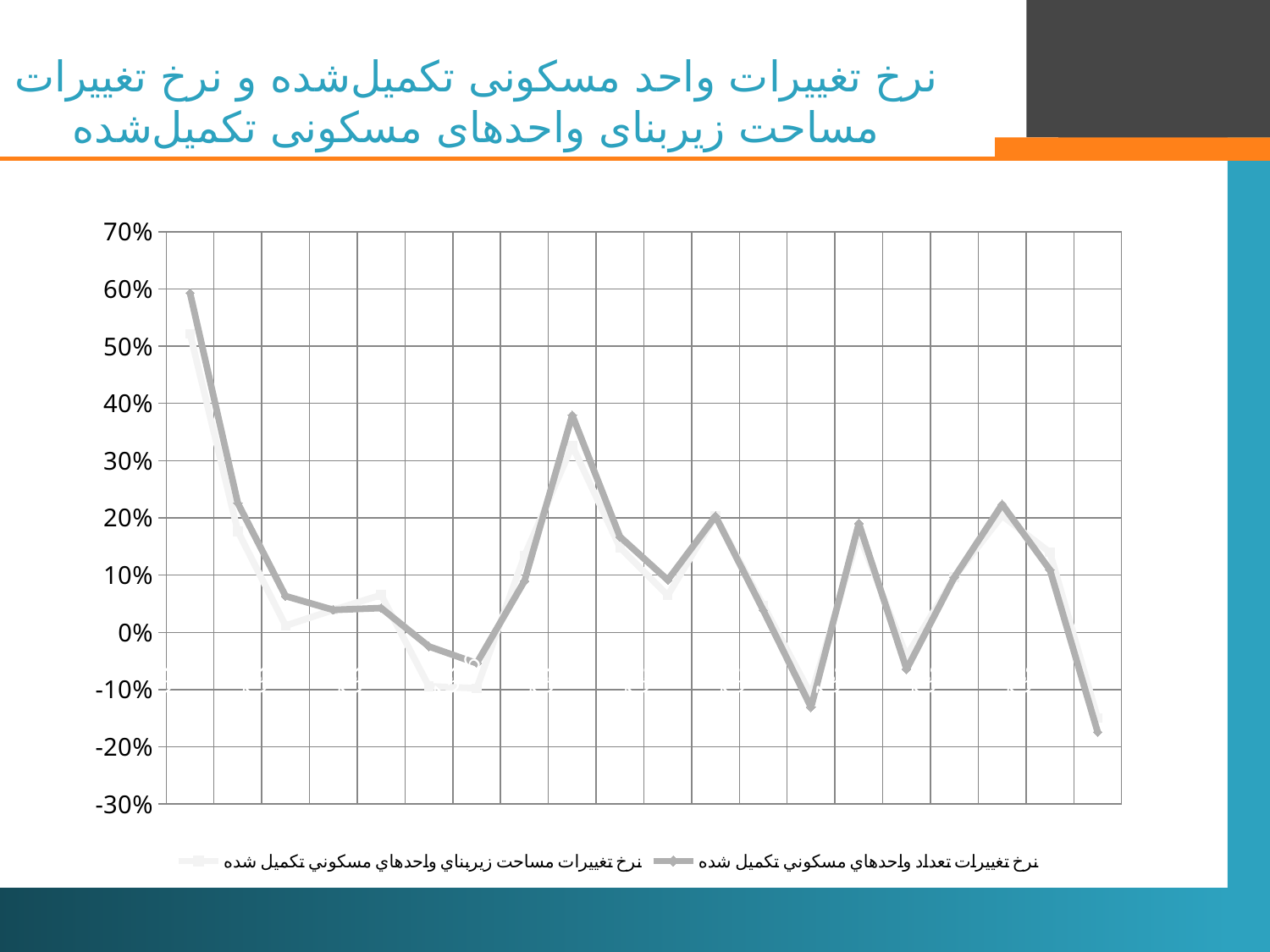
Overall, do the values of the dark grey series rise or fall from the first point to the last point? fall Is the last value of the dark grey series greater or less than -10%? less Is the first value of the light series (نرخ تغییرات تعداد واحدهای مسکونی تکمیل شده) greater or less than 40%? greater Which legend entry is drawn in dark grey? نرخ تغييرات تعداد واحدهاي مسكوني تكميل شده How many data points does each line have? 20 Is the highest value of the dark grey series in the middle of the chart greater or less than 30%? greater What is the highest value shown on the vertical axis? 70% At the first point, which series has the larger value: the dark grey series or the light series? the dark grey series (نرخ تغييرات تعداد واحدهاي مسكوني تكميل شده) Is the highest value of the dark grey series at the first point or the last point? the first point What kind of chart is shown on the slide? line chart How many series does the legend list? 2